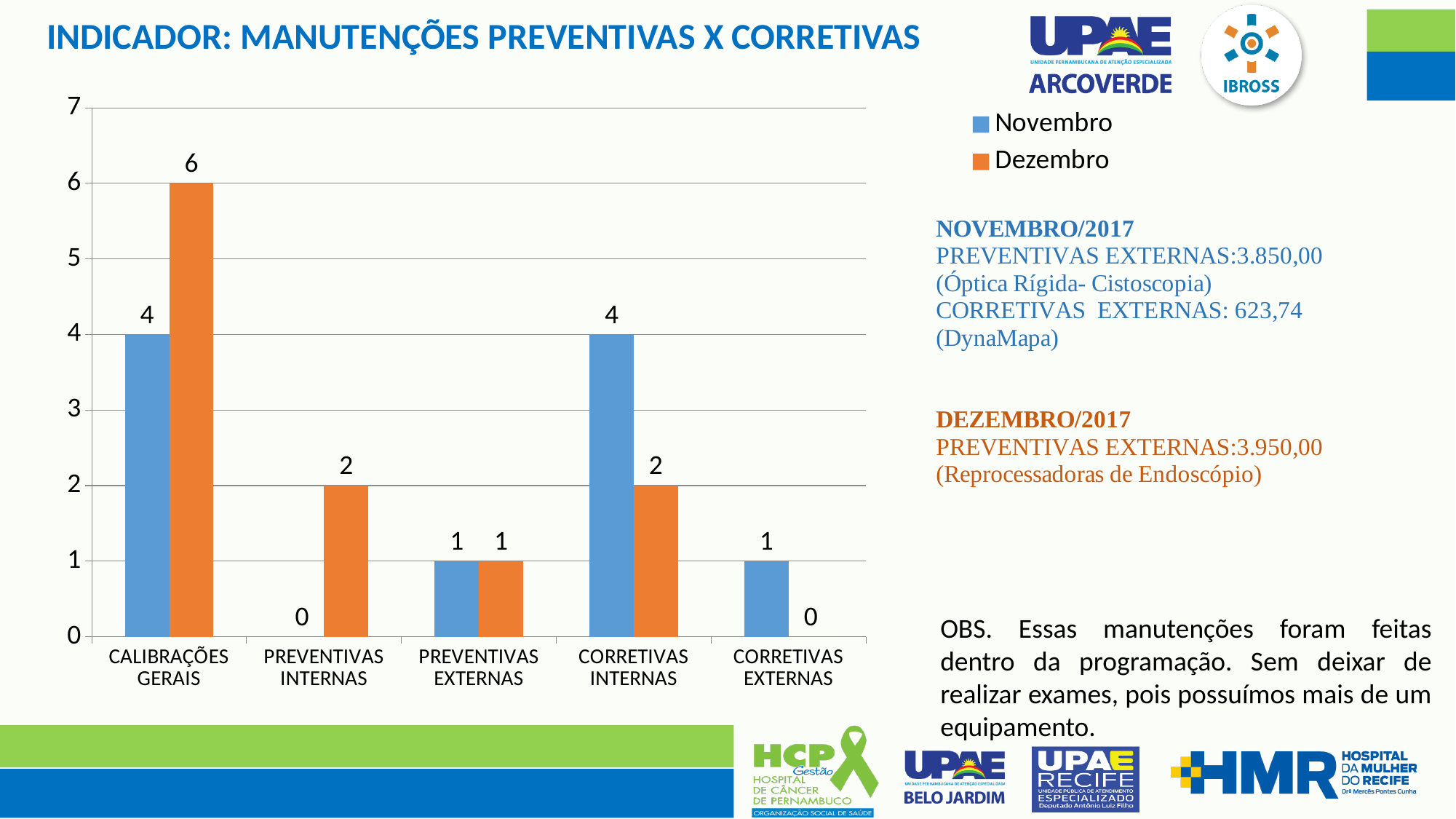
For CORRETIVAS INTERNAS, which series has the larger value, Novembro or Dezembro? Novembro How many series does the legend list? 2 Which colour represents Dezembro in the chart? Orange What is the Dezembro value for CALIBRAÇÕES GERAIS? 6 What is the difference between the Dezembro and Novembro values for CALIBRAÇÕES GERAIS? 2 What is the Novembro value for PREVENTIVAS INTERNAS? 0 What is the Dezembro value for CORRETIVAS EXTERNAS? 0 What kind of chart is shown on the slide? Bar chart What is the Novembro value for CORRETIVAS INTERNAS? 4 Which category has the highest Dezembro value? CALIBRAÇÕES GERAIS How many categories are shown on the x axis? 5 Which category has the lowest Novembro value? PREVENTIVAS INTERNAS